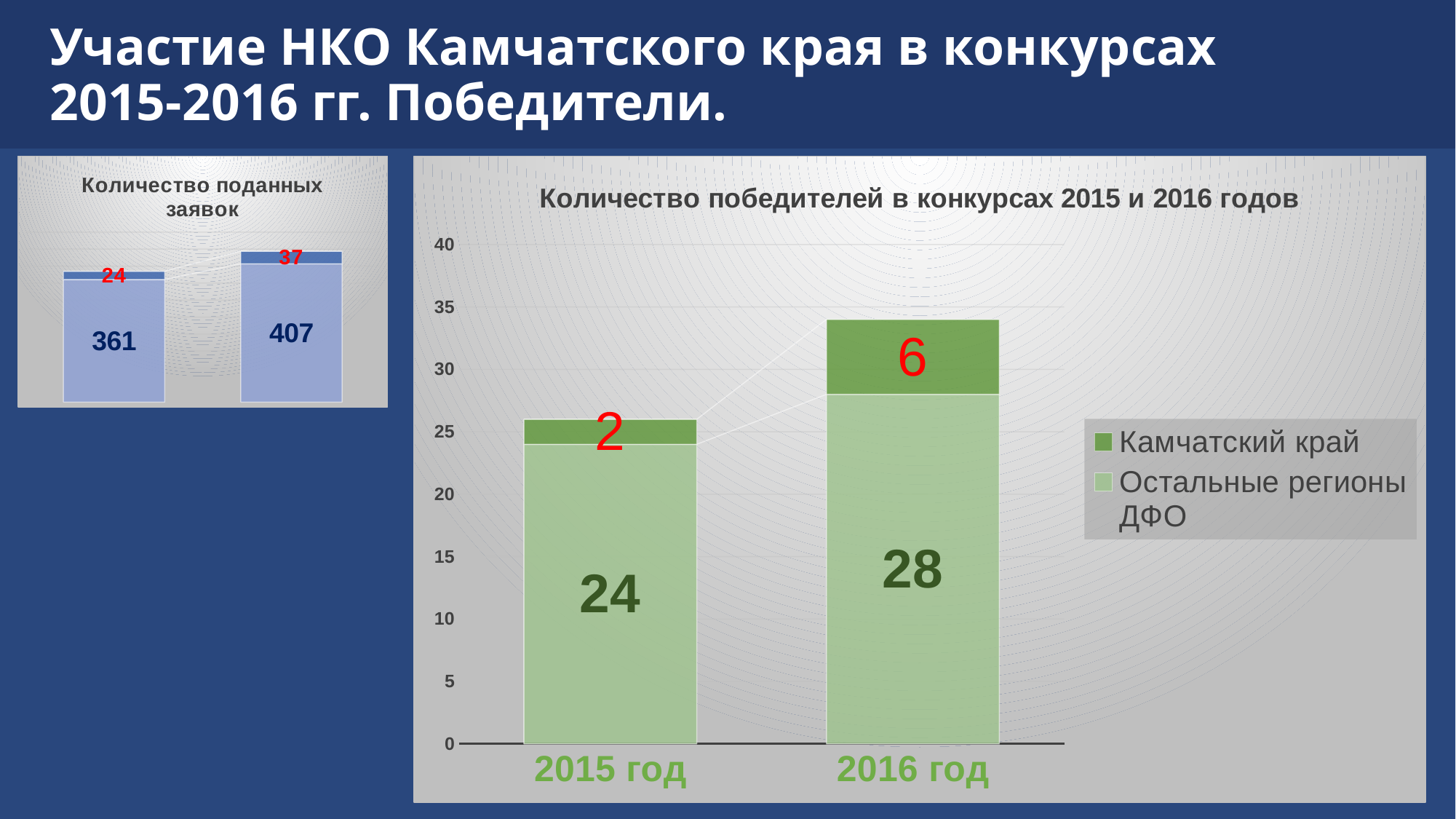
In the chart titled 'Количество победителей в конкурсах 2015 и 2016 годов', by how much did the value for Камчатский край increase from 2015 год to 2016 год? 4 In the chart titled 'Количество победителей в конкурсах 2015 и 2016 годов', what is the value for Камчатский край in 2016 год? 6 In the chart titled 'Количество поданных заявок' on the left of the slide, what is the difference between the values printed in the large light-blue segments of the right bar and the left bar? 46 In the chart titled 'Количество победителей в конкурсах 2015 и 2016 годов', what is the value for Остальные регионы ДФО in 2016 год? 28 In the chart titled 'Количество победителей в конкурсах 2015 и 2016 годов', how many series does the legend list? 2 In the chart titled 'Количество победителей в конкурсах 2015 и 2016 годов', what is the total of the stacked bar for 2015 год? 26 In the chart titled 'Количество победителей в конкурсах 2015 и 2016 годов', what is the value for Камчатский край in 2015 год? 2 In the chart titled 'Количество победителей в конкурсах 2015 и 2016 годов', does the value for Остальные регионы ДФО rise or fall from 2015 год to 2016 год? rise In the chart titled 'Количество поданных заявок' on the left of the slide, what is the value printed in the large light-blue segment of the right bar? 407 What kind of chart is the chart titled 'Количество победителей в конкурсах 2015 и 2016 годов'? stacked bar chart In the chart titled 'Количество победителей в конкурсах 2015 и 2016 годов', what is the total of the stacked bar for 2016 год? 34 In the chart titled 'Количество победителей в конкурсах 2015 и 2016 годов', which series is shown in dark green in the legend? Камчатский край